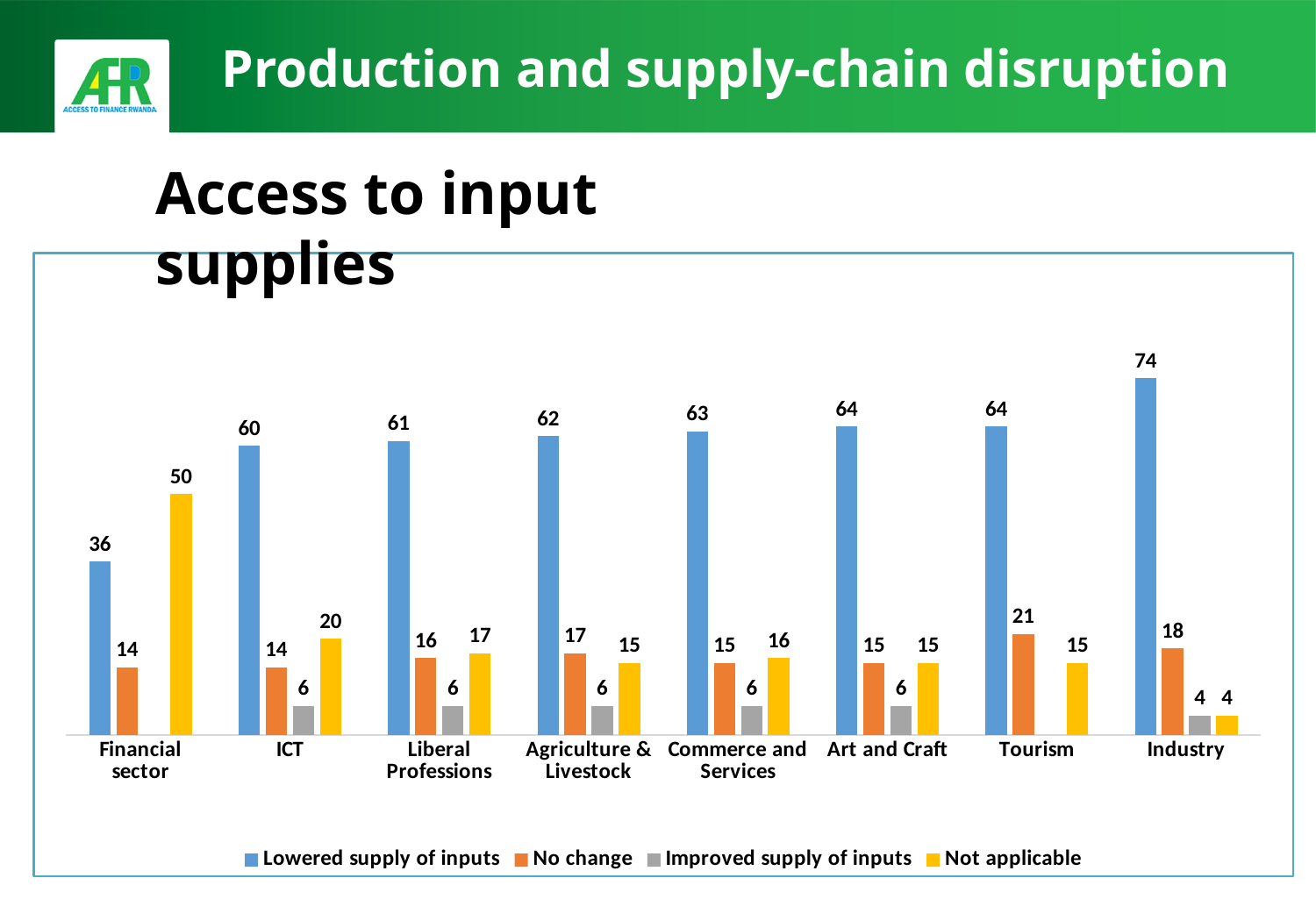
What is the difference between the 'Lowered supply of inputs' values for Industry and ICT? 14 How many series does the legend list? 4 What is the 'Improved supply of inputs' value for Industry? 4 Which series is shown in yellow in the legend? Not applicable How many categories are shown on the x axis? 8 What kind of chart is shown on the slide? Bar chart Which is larger: the 'Not applicable' value for ICT or for Liberal Professions? ICT What is the 'Not applicable' value for the Financial sector? 50 Which category has the lowest 'Lowered supply of inputs' value? Financial sector Which category has the highest 'Lowered supply of inputs' value? Industry What is the 'No change' value for Tourism? 21 What is the value for 'Lowered supply of inputs' in the Industry category? 74